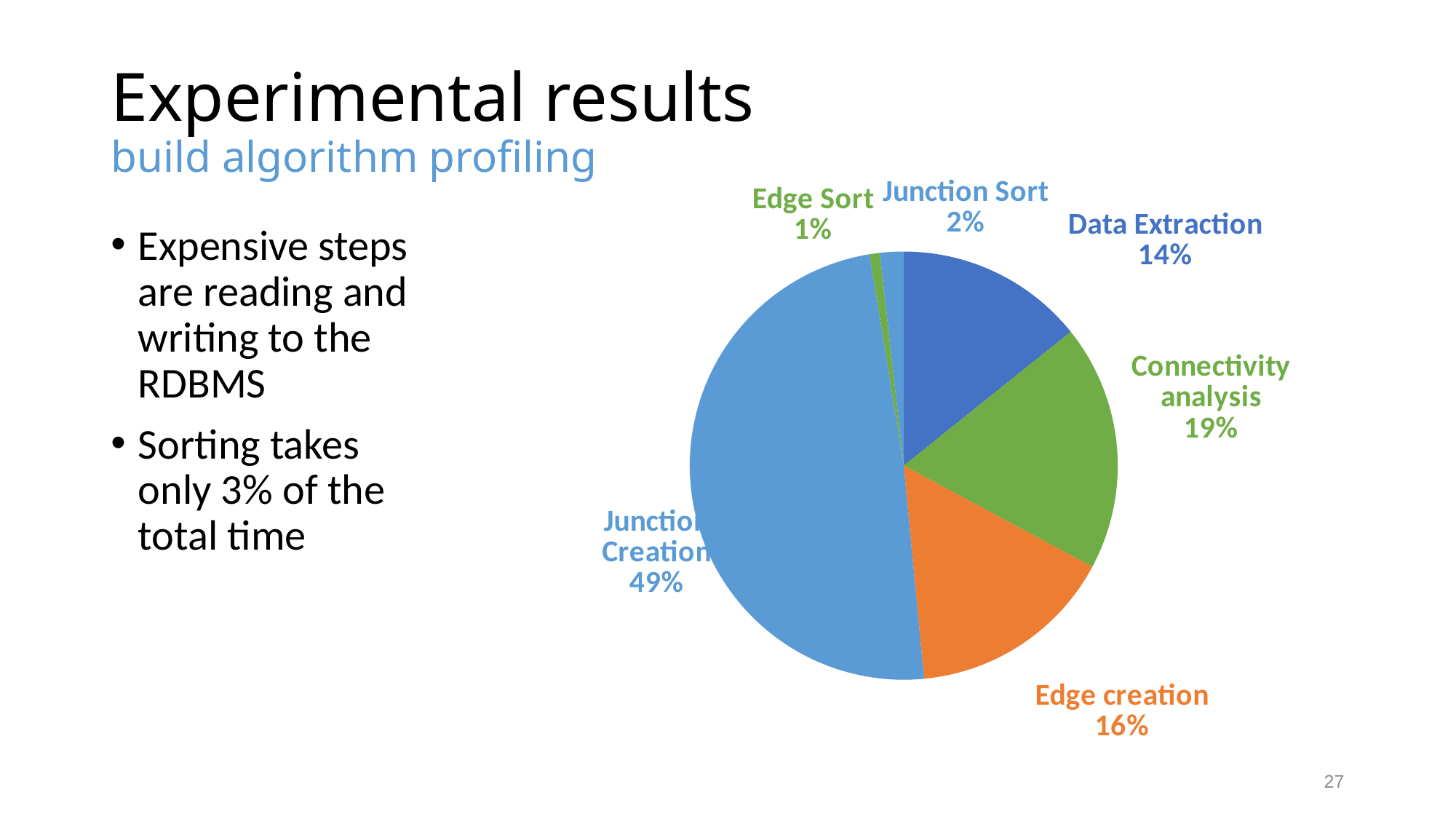
What colour is the Edge creation slice? orange Which slice of the pie is the smallest? Edge Sort What share of the pie does Data Extraction take? 14% What share of the pie does Connectivity analysis take? 19% Which is larger, the share for Data Extraction or the share for Edge creation? Edge creation What share of the pie does Junction Sort take? 2% What kind of chart is shown on the slide? pie chart How many slices does the pie chart have? 6 Which slice of the pie is the largest? Junction Creation What is the difference in percentage points between Connectivity analysis and Edge creation? 3%